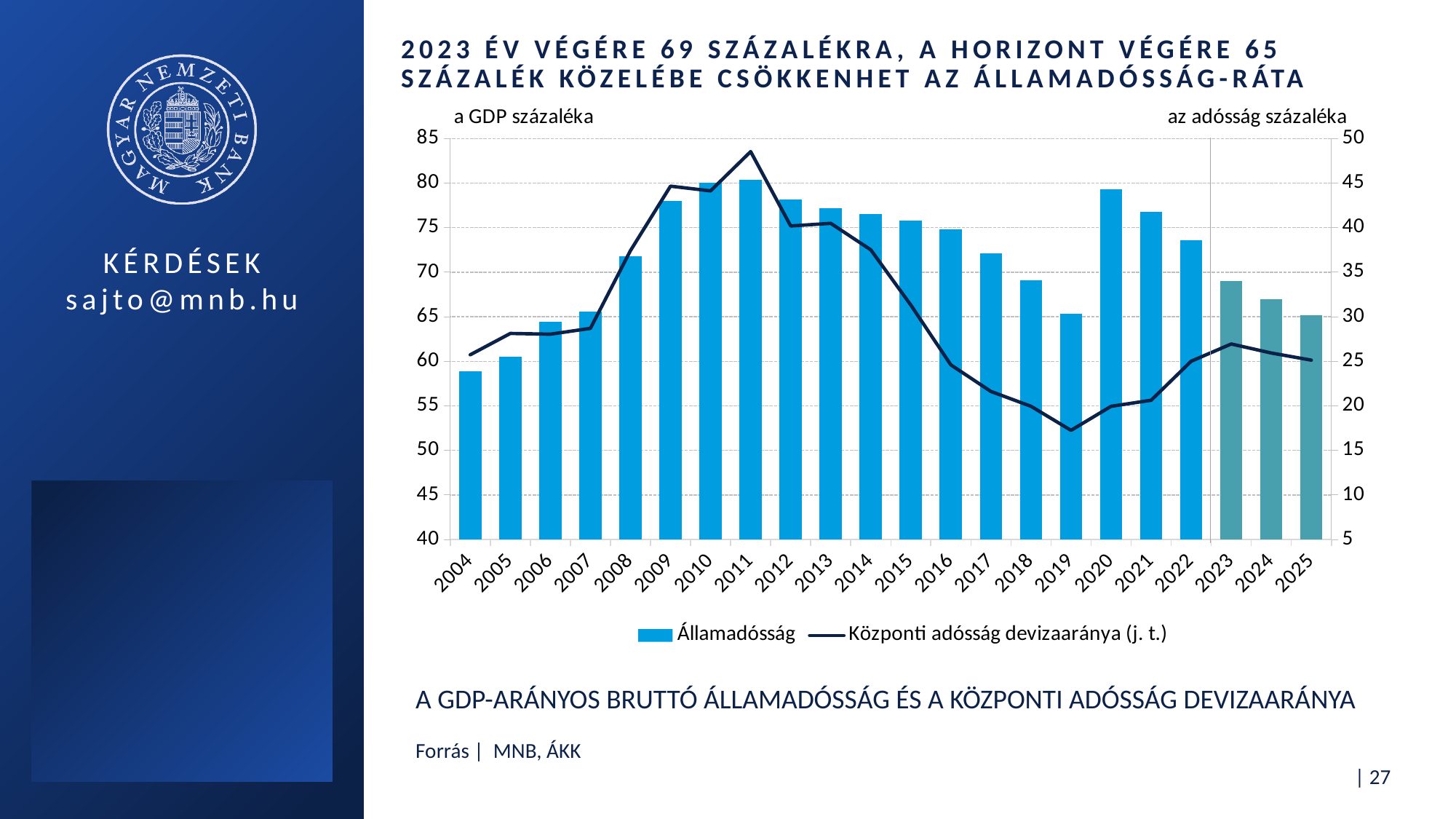
Which year has the lowest Államadósság bar? 2004 In which year does the Központi adósság devizaaránya line reach its lowest point? 2019 Is the Államadósság value for 2019 greater or less than 70? less How many series does the chart legend list? 2 Is the Államadósság bar for 2009 taller or shorter than the bar for 2019? taller What kind of chart is shown on the slide? A bar chart combined with a line chart Which year has the highest Államadósság bar? 2011 Is the Államadósság value for 2004 greater or less than 60? less Do the Államadósság bars rise or fall from 2011 to 2019? fall What is the label of the line series in the legend? Központi adósság devizaaránya (j. t.) How many years are shown on the x axis of the chart? 22